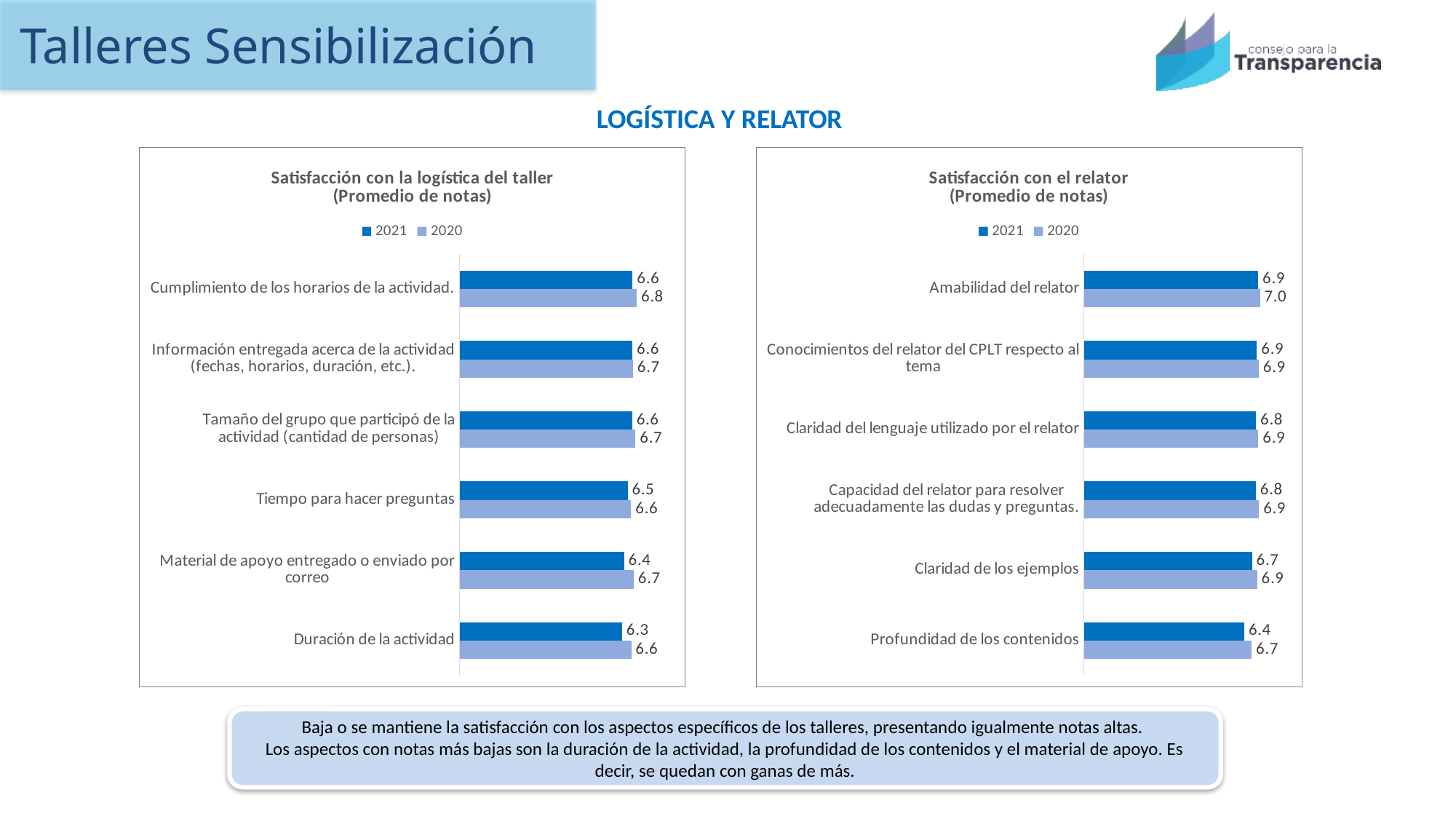
In the 'Satisfacción con la logística del taller' chart, which category has the lowest 2021 value? Duración de la actividad In the 'Satisfacción con la logística del taller' chart, what is the difference between the 2020 and 2021 values for 'Material de apoyo entregado o enviado por correo'? 0.3 In the 'Satisfacción con la logística del taller' chart, what is the 2021 value for 'Duración de la actividad'? 6.3 How many series does the legend of the 'Satisfacción con el relator' chart list? 2 In the 'Satisfacción con el relator' chart, what is the 2021 value for 'Profundidad de los contenidos'? 6.4 In the 'Satisfacción con el relator' chart, what is the 2020 value for 'Amabilidad del relator'? 7.0 In the 'Satisfacción con el relator' chart, what is the difference between the 2020 and 2021 values for 'Profundidad de los contenidos'? 0.3 In the 'Satisfacción con la logística del taller' chart, what is the 2020 value for 'Cumplimiento de los horarios de la actividad.'? 6.8 What type of chart is the 'Satisfacción con el relator' chart? Bar chart In the 'Satisfacción con el relator' chart, which category has the lowest 2020 value? Profundidad de los contenidos How many categories are shown in the 'Satisfacción con la logística del taller' chart? 6 In the 'Satisfacción con el relator' chart, which is larger for 'Claridad de los ejemplos': the 2021 value or the 2020 value? 2020